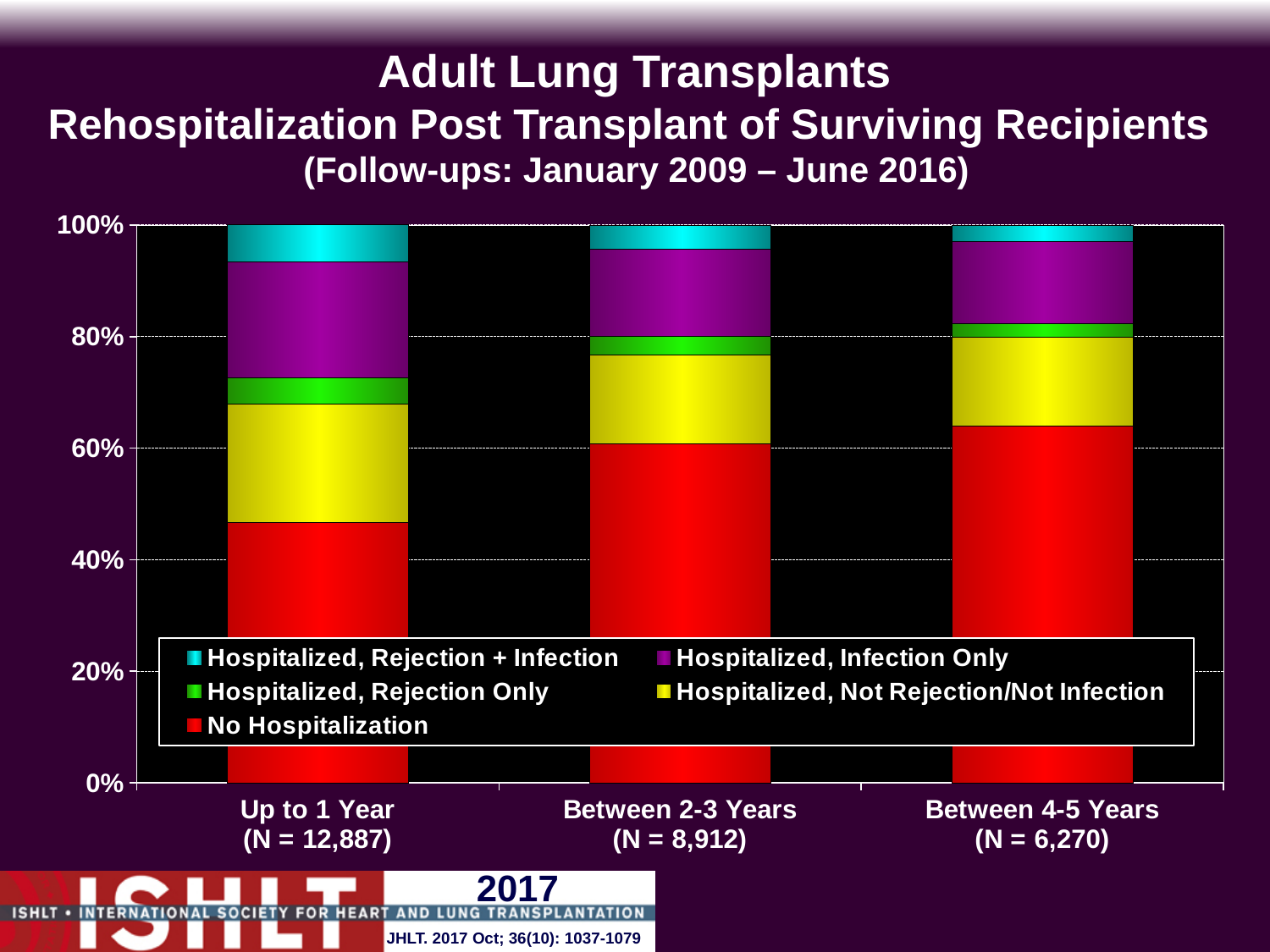
Which colour represents No Hospitalization in the legend? Red How many series does the legend list? 5 How many age-since-transplant categories are shown on the x axis? 3 Is the No Hospitalization share for Between 4-5 Years greater or less than 60%? greater Which category has the lowest No Hospitalization share? Up to 1 Year Does the No Hospitalization share rise or fall from Up to 1 Year to Between 4-5 Years? rise What kind of chart is shown on the slide? Stacked bar chart Is the No Hospitalization share for Up to 1 Year greater or less than 40%? greater Is the Hospitalized, Rejection + Infection share larger for Up to 1 Year or for Between 4-5 Years? Up to 1 Year What does each stacked bar total? 100% What is the N shown for the Up to 1 Year category? N = 12,887 Is the No Hospitalization share for Up to 1 Year greater or less than 60%? less